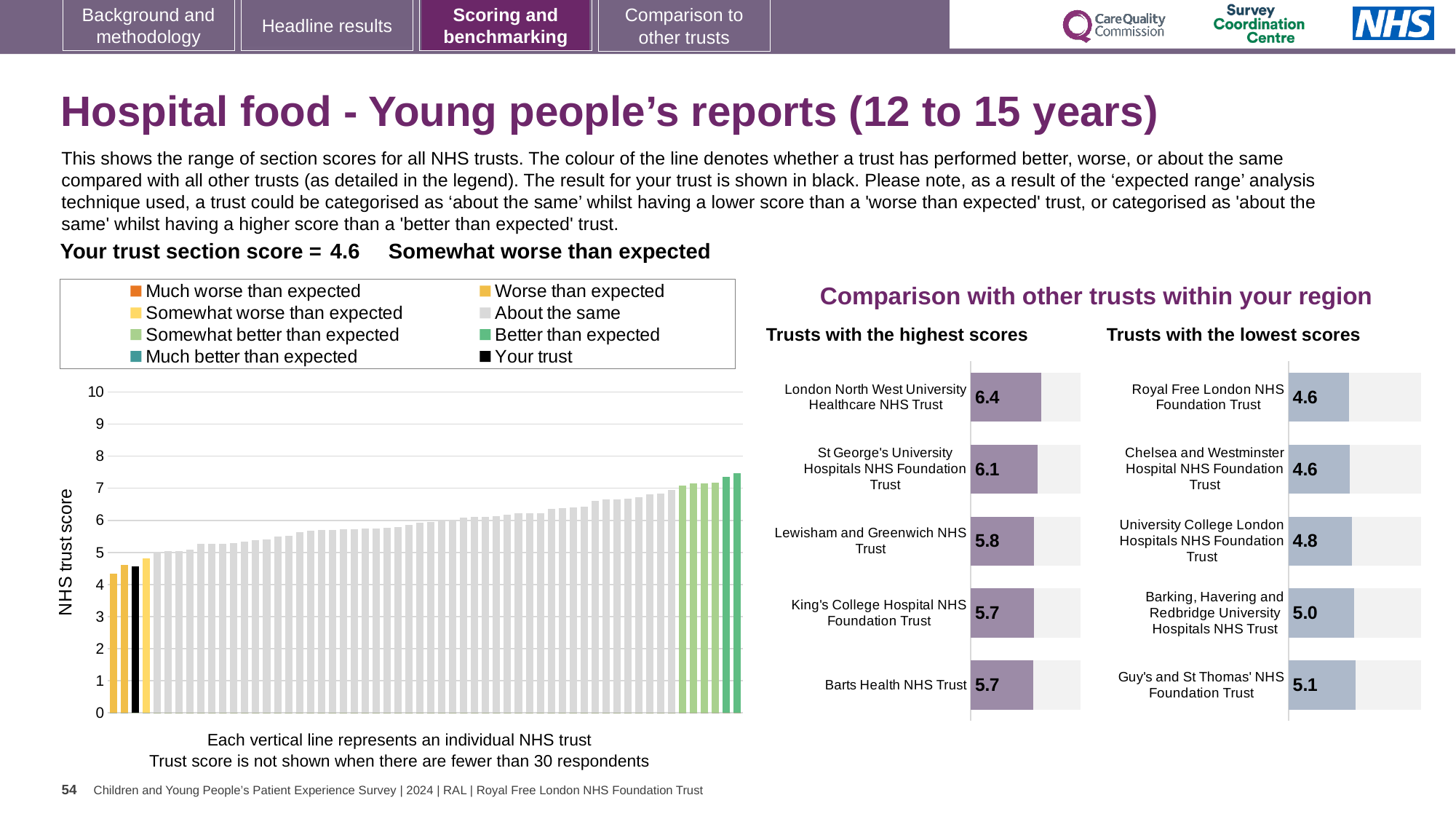
In the large chart on the left, is the value for the black 'Your trust' bar greater or less than 5? less In the 'Trusts with the highest scores' chart, what is the score for London North West University Healthcare NHS Trust? 6.4 In the 'Trusts with the lowest scores' chart, what is the difference between the scores of Guy's and St Thomas' NHS Foundation Trust and Royal Free London NHS Foundation Trust? 0.5 How many trusts are shown in the 'Trusts with the highest scores' chart? 5 In the 'Trusts with the highest scores' chart, which trust has the highest score? London North West University Healthcare NHS Trust How many entries does the legend of the large chart on the left list? 8 In the 'Trusts with the lowest scores' chart, which has the larger score: University College London Hospitals NHS Foundation Trust or Barking, Havering and Redbridge University Hospitals NHS Trust? Barking, Havering and Redbridge University Hospitals NHS Trust In the 'Trusts with the highest scores' chart, what is the difference between the scores of London North West University Healthcare NHS Trust and St George's University Hospitals NHS Foundation Trust? 0.3 In the 'Trusts with the lowest scores' chart, what is the score for University College London Hospitals NHS Foundation Trust? 4.8 In the large chart on the left, do the trust scores rise or fall from left to right? rise In the 'Trusts with the highest scores' chart, what is the score for Lewisham and Greenwich NHS Trust? 5.8 In the 'Trusts with the lowest scores' chart, which trust has the highest score? Guy's and St Thomas' NHS Foundation Trust